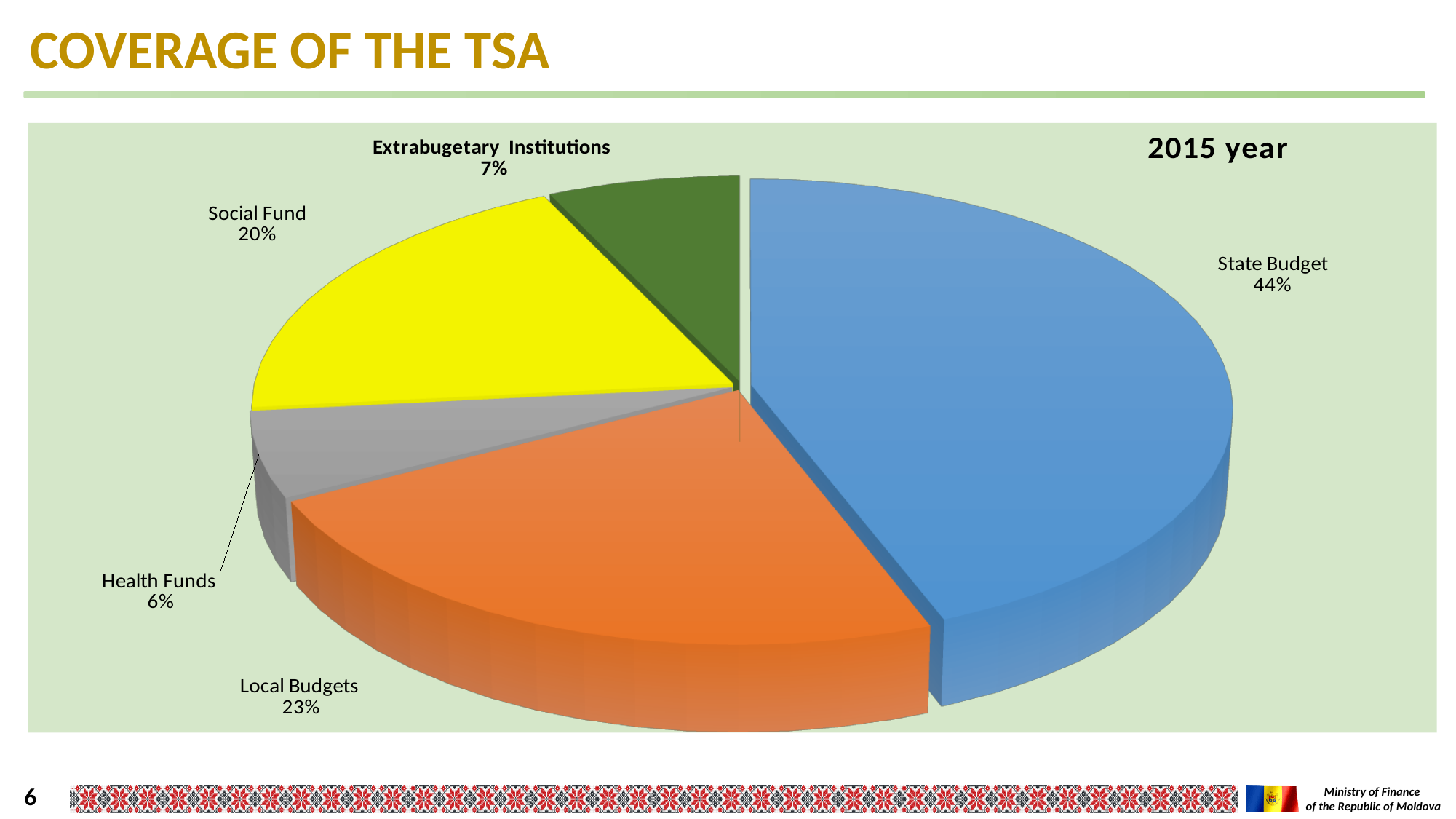
What share of the pie does Extrabugetary Institutions have? 7% What share of the pie does Health Funds have? 6% What is the difference in percentage points between State Budget and Local Budgets? 21 Which is larger, Social Fund or Local Budgets? Local Budgets How many categories are shown in the pie chart? 5 Which year does the chart refer to? 2015 Which category has the largest share of the pie? State Budget What share of the pie does State Budget have? 44% What kind of chart is shown on the slide? Pie chart Which category has the smallest share of the pie? Health Funds What share of the pie does Social Fund have? 20% What share of the pie does Local Budgets have? 23%